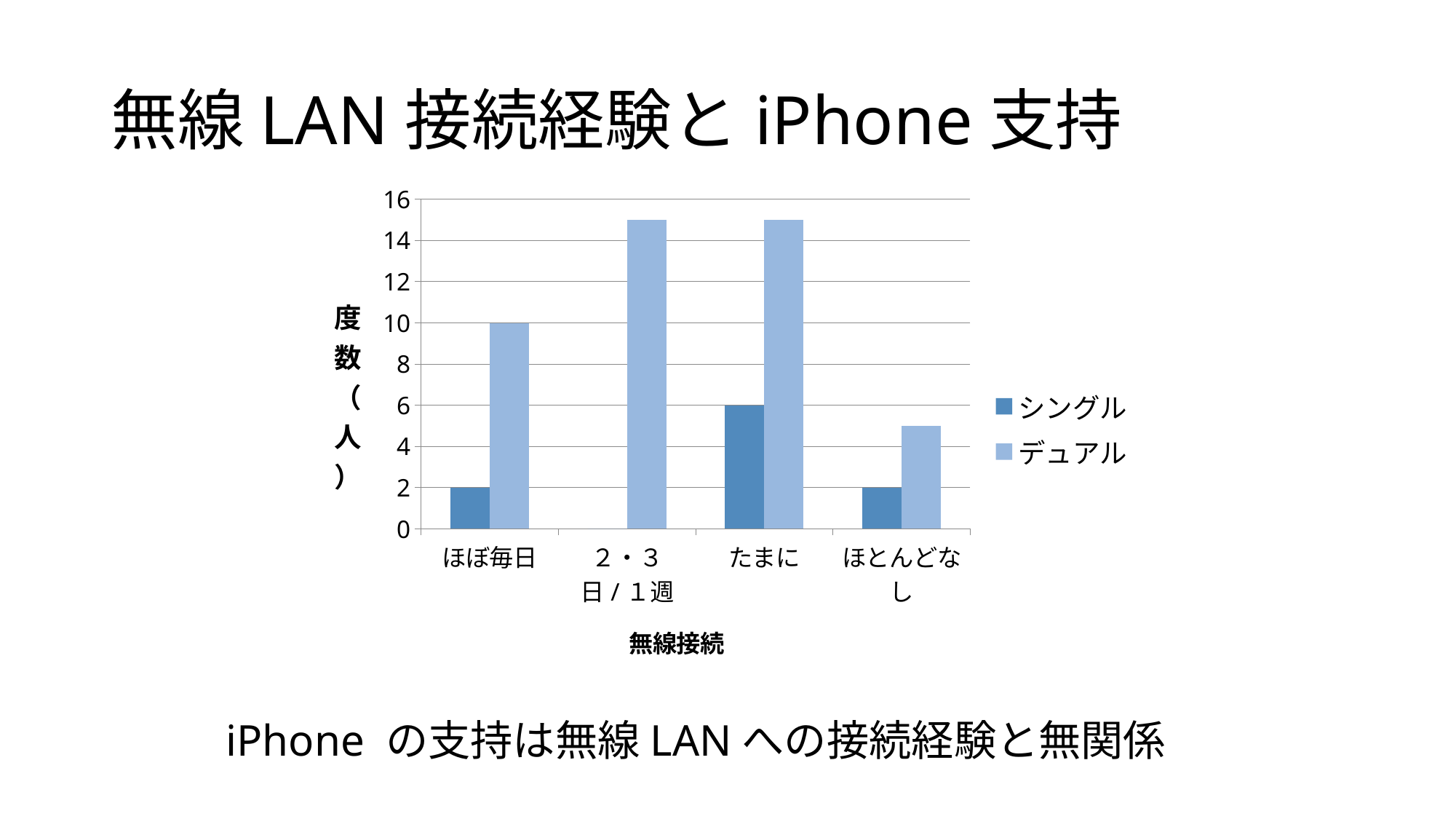
What kind of chart is shown on the slide? bar chart Is the value for デュアル in the ほとんどなし category greater or less than 6? less Is the value for デュアル in the ２・３日/１週 category greater or less than 14? greater Which category has the lowest value for デュアル? ほとんどなし What is the value for シングル in the ほぼ毎日 category? 2 How many series does the legend list? 2 Which category has the highest value for シングル? たまに How many categories are shown on the x axis? 4 What is the value for シングル in the たまに category? 6 What is the value for デュアル in the ほぼ毎日 category? 10 What is the title of the slide? 無線 LAN 接続経験と iPhone 支持 What is the difference between the デュアル and シングル values in the ほぼ毎日 category? 8